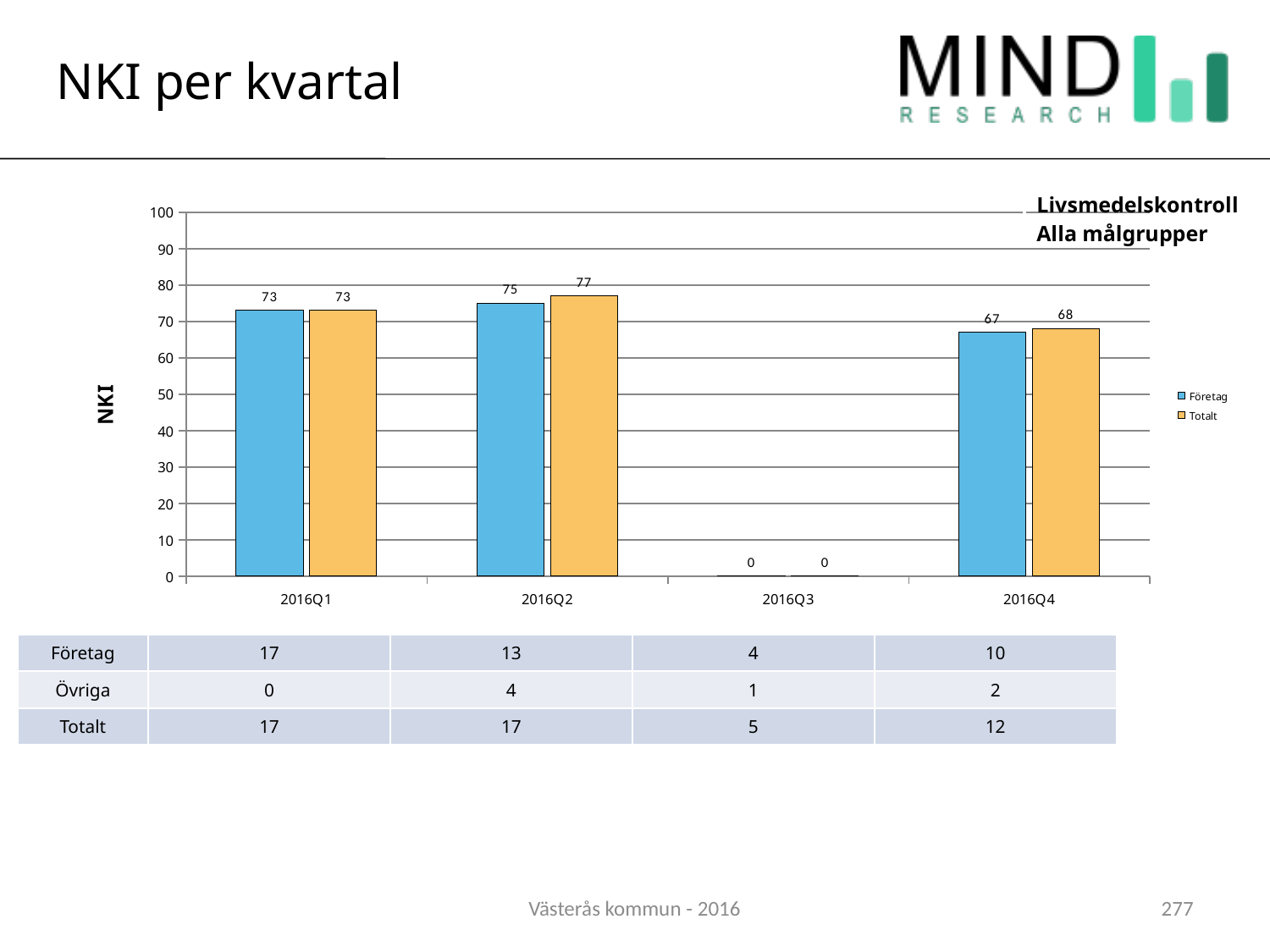
Which is larger, the Företag NKI value in 2016Q1 or in 2016Q4? 2016Q1 Which quarter has the highest Totalt NKI value? 2016Q2 What is the NKI value for Totalt in 2016Q1? 73 What kind of chart is shown on the slide? Bar chart How many series does the chart legend list? 2 How many quarters are shown on the x axis of the chart? 4 Which quarter has the lowest Företag NKI value? 2016Q3 What is the NKI value for Företag in 2016Q2? 75 What is the difference between the Företag NKI value in 2016Q2 and in 2016Q4? 8 What is the NKI value for Totalt in 2016Q4? 68 What is the label on the vertical axis of the chart? NKI What is the difference between the Totalt and Företag NKI values in 2016Q2? 2